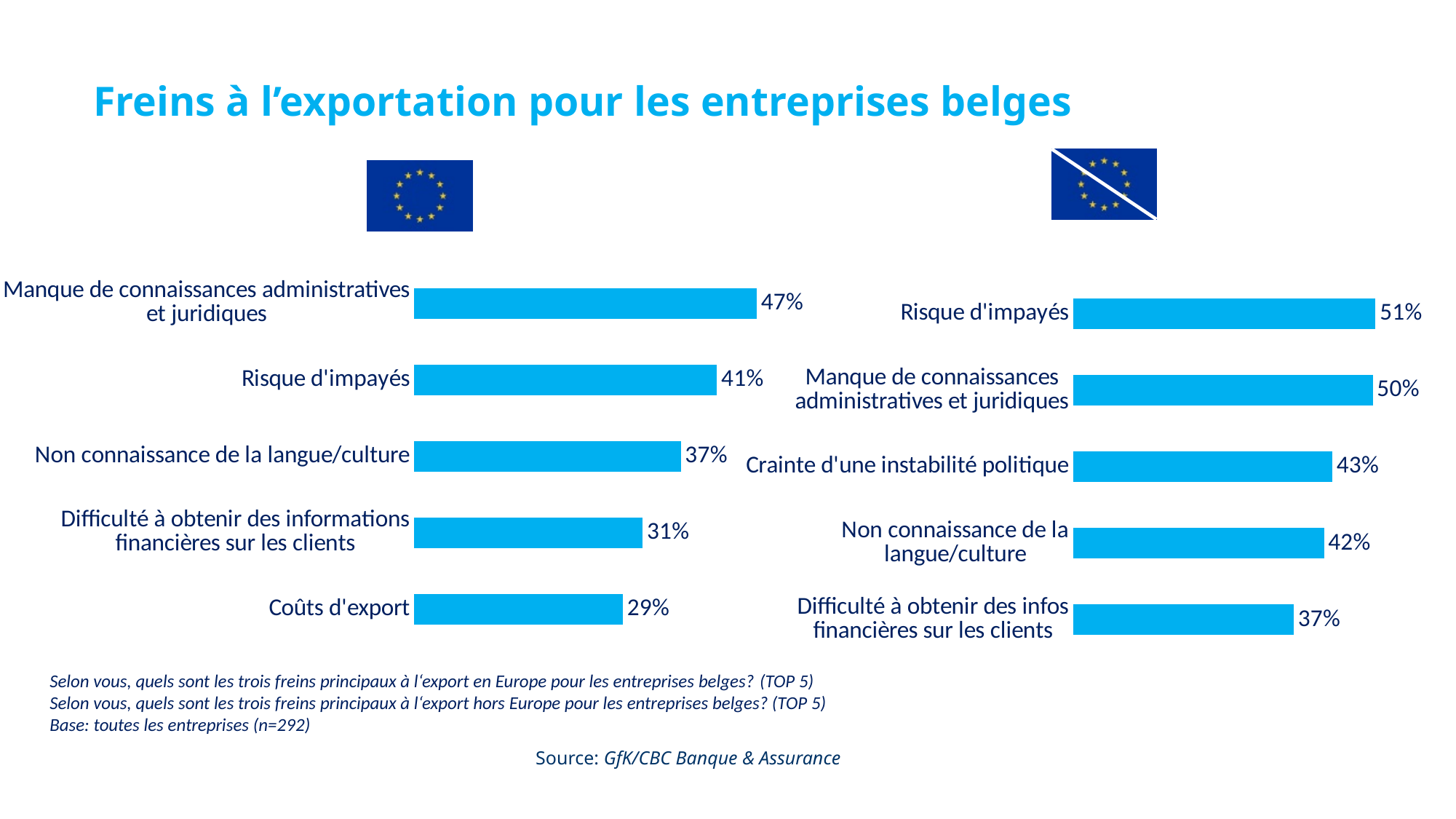
In the left chart (export within Europe), what is the difference between "Manque de connaissances administratives et juridiques" and "Coûts d'export"? 18% In the right chart (export outside Europe), what is the difference between "Risque d'impayés" and "Non connaissance de la langue/culture"? 9% In the left chart (export within Europe), what is the value for "Risque d'impayés"? 41% Is the value for "Non connaissance de la langue/culture" larger in the left chart (within Europe) or the right chart (outside Europe)? Right chart (outside Europe) In the right chart (export outside Europe), what is the value for "Manque de connaissances administratives et juridiques"? 50% In the right chart (export outside Europe), which category has the lowest value? Difficulté à obtenir des infos financières sur les clients What is the title of the slide? Freins à l'exportation pour les entreprises belges In the left chart (export within Europe), which category has the highest value? Manque de connaissances administratives et juridiques In the left chart (export within Europe), what is the value for "Coûts d'export"? 29% In the left chart (export within Europe), how many categories are shown? 5 In the right chart (export outside Europe), what is the value for "Crainte d'une instabilité politique"? 43% What type of chart is used on this slide? Bar chart